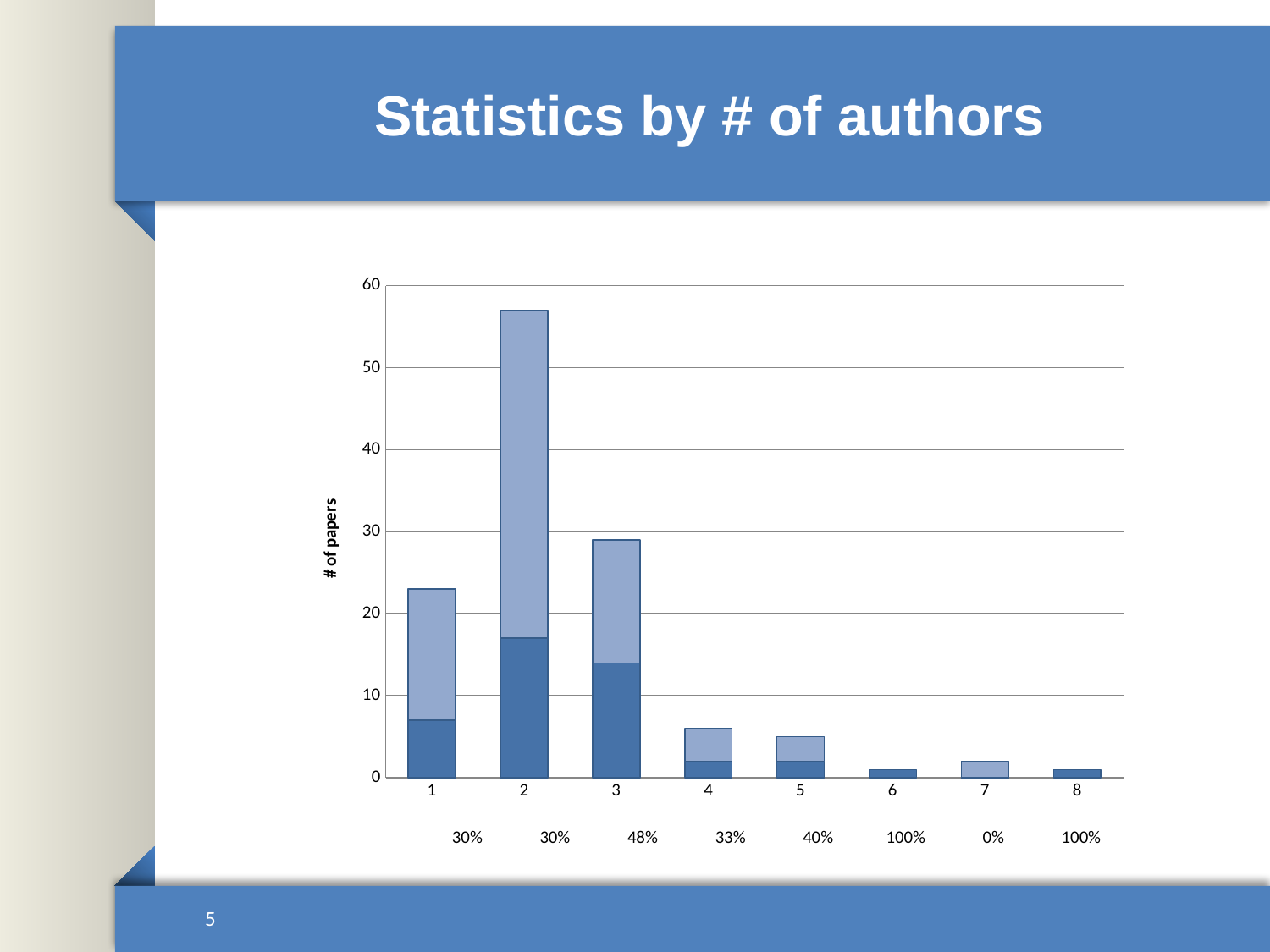
Do the total bar heights rise or fall as the number of authors increases from 2 to 8? fall What kind of chart is shown on the slide? bar chart What is the title of the slide's chart? Statistics by # of authors Which has a larger total number of papers: 1 author or 3 authors? 3 authors What is the label on the vertical axis of the chart? # of papers Is the total number of papers for 4 authors greater or less than 10? less Is the total number of papers for 1 author greater or less than 20? greater Which number of authors has the highest total number of papers? 2 Is the total number of papers for 2 authors greater or less than 50? greater What percentage is printed below the bar for 3 authors? 48% How many categories are shown along the x axis of the chart? 8